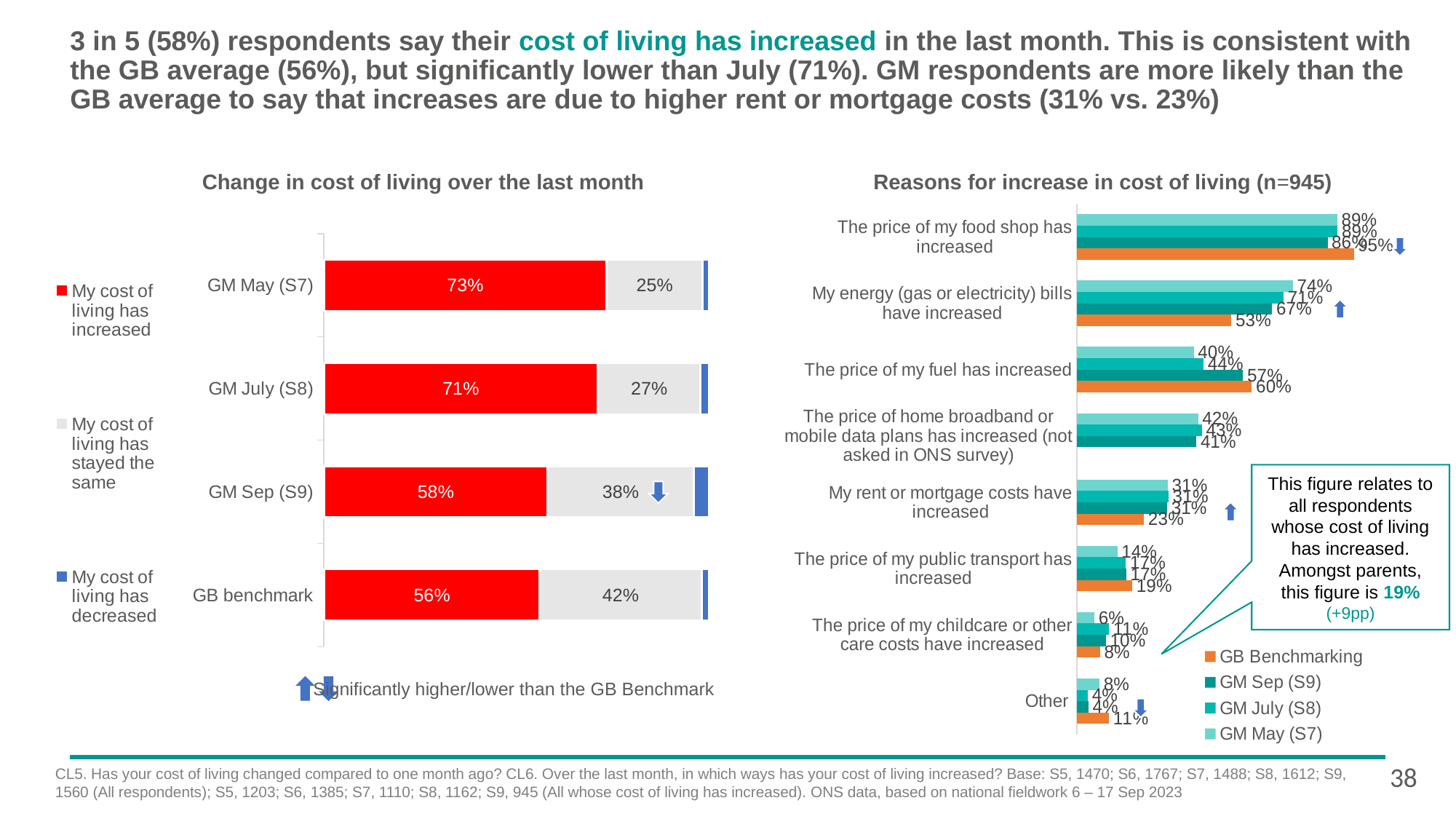
In the 'Change in cost of living over the last month' chart, what is the difference between the GM July (S8) and GM Sep (S9) values for 'My cost of living has increased'? 13 percentage points In the 'Change in cost of living over the last month' chart, what percentage of GB benchmark respondents say their cost of living has stayed the same? 42% In the 'Change in cost of living over the last month' chart, how many series does the legend list? 3 In the 'Reasons for increase in cost of living (n=945)' chart, what is the GB Benchmarking value for 'The price of my food shop has increased'? 95% In the 'Reasons for increase in cost of living (n=945)' chart, what is the GM Sep (S9) value for 'My energy (gas or electricity) bills have increased'? 67% How many reason categories are shown in the 'Reasons for increase in cost of living (n=945)' chart? 8 What kind of chart is 'Change in cost of living over the last month'? Stacked bar chart In the 'Change in cost of living over the last month' chart, which category has the highest share saying their cost of living has increased? GM May (S7) In the 'Reasons for increase in cost of living (n=945)' chart, what is the difference between the GM Sep (S9) and GB Benchmarking values for 'My rent or mortgage costs have increased'? 8 percentage points In the 'Reasons for increase in cost of living (n=945)' chart, which is larger for 'The price of my fuel has increased': GM Sep (S9) or GM May (S7)? GM Sep (S9) In the 'Reasons for increase in cost of living (n=945)' chart, how many series does the legend list? 4 In the 'Change in cost of living over the last month' chart, what percentage of GM Sep (S9) respondents say their cost of living has increased? 58%